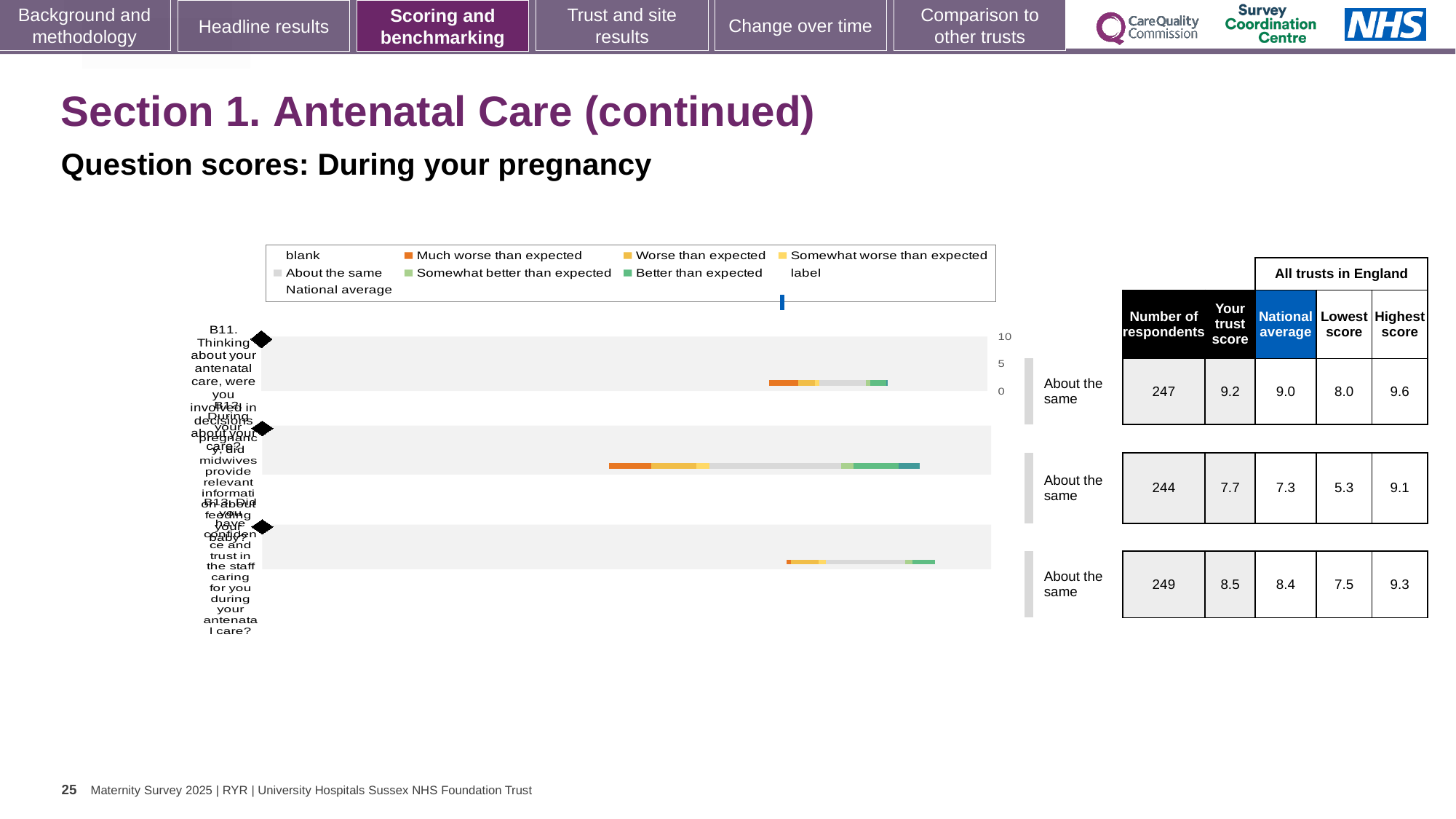
What is the difference between the trust score and the national average for question B11? 0.2 What is the subtitle describing the chart's content? Question scores: During your pregnancy What is the national average for question B12? 7.3 How many respondents answered question B13? 249 What kind of chart is shown on the slide? bar chart What is the 'Your trust score' for question B11? 9.2 What benchmark category is shown for question B12? About the same For question B13, which is larger: the trust score or the national average? the trust score (8.5) Which question has the lowest 'Your trust score'? B12 How many questions (bars) are plotted in the chart? 3 Which question has the highest 'Your trust score'? B11 What is the highest score across all trusts in England for question B12? 9.1